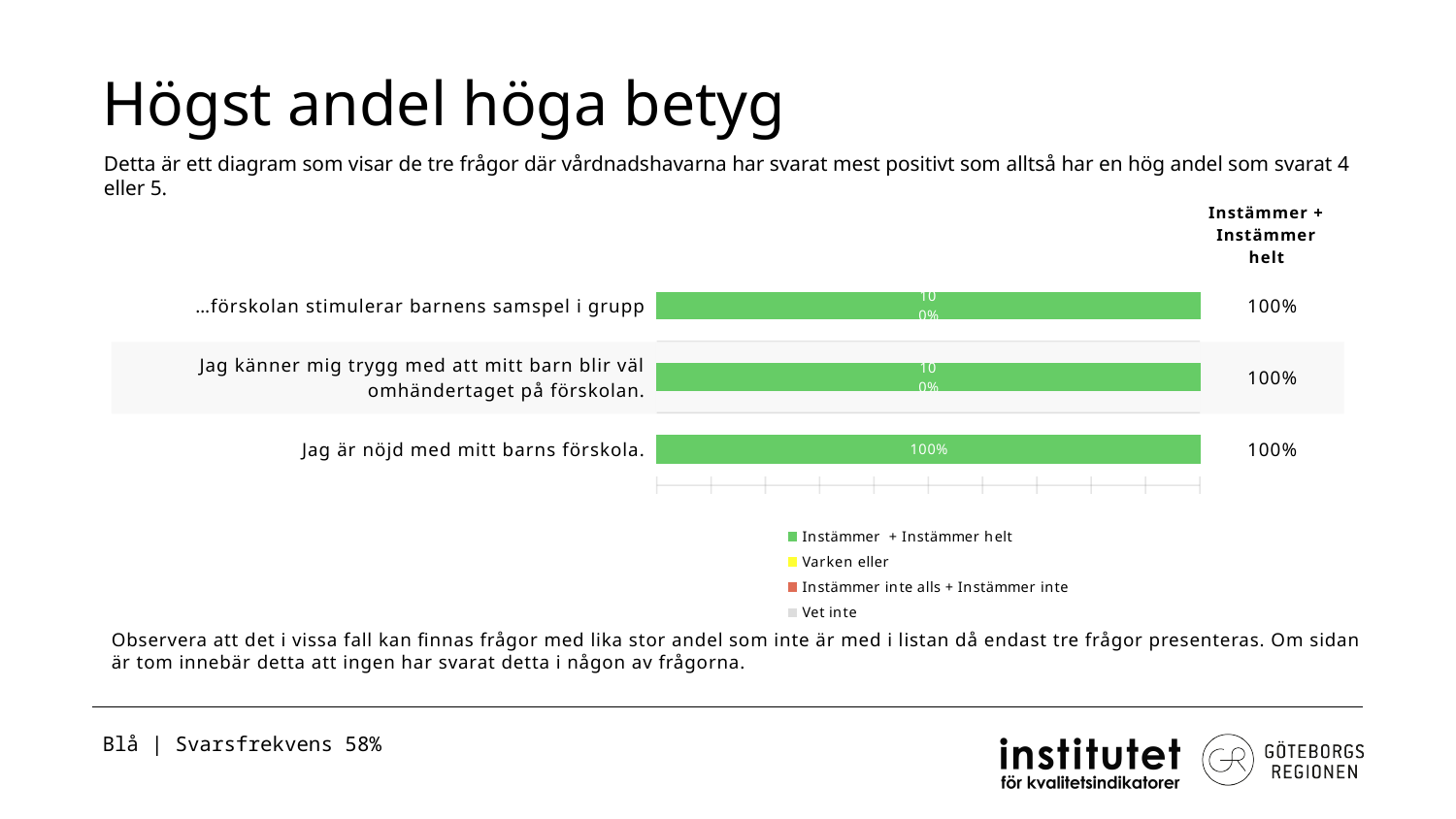
Which legend entry is shown in yellow? Varken eller Which legend entry is shown in green? Instämmer + Instämmer helt What is the 'Instämmer + Instämmer helt' value for 'Jag är nöjd med mitt barns förskola.'? 100% What is the 'Instämmer + Instämmer helt' value for '…förskolan stimulerar barnens samspel i grupp'? 100% What is the difference between the 'Instämmer + Instämmer helt' values for 'Jag är nöjd med mitt barns förskola.' and '…förskolan stimulerar barnens samspel i grupp'? 0% What is the 'Instämmer + Instämmer helt' value for 'Jag känner mig trygg med att mitt barn blir väl omhändertaget på förskolan.'? 100% How many series does the legend list? 4 How many questions (categories) are plotted in the chart? 3 What kind of chart is shown on the slide? bar chart Is the 'Instämmer + Instämmer helt' value for 'Jag är nöjd med mitt barns förskola.' greater or less than 50%? greater